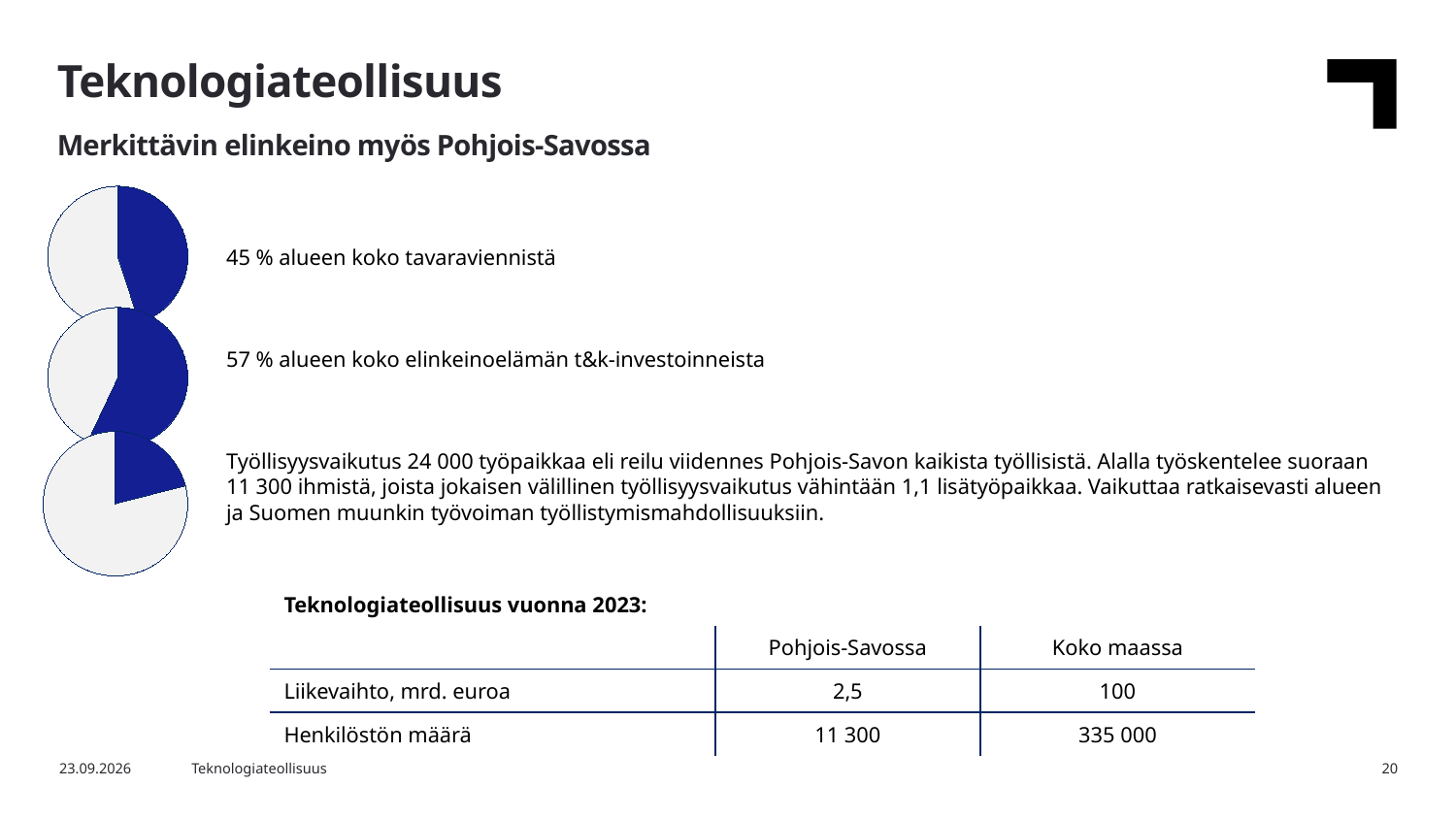
What is the difference in percentage points between the shares shown for the middle pie chart (57 %) and the top pie chart (45 %)? 12 percentage points How many pie charts are on the slide? 3 In the bottom pie chart, is the blue slice greater or less than 50% of the pie? less What kind of charts are shown on the left side of the slide? Pie charts Which pie chart has the smallest blue slice: the top, middle or bottom one? Bottom How many slices does each pie chart have? 2 In the middle pie chart, is the blue slice greater or less than 50% of the pie? greater What colour is the highlighted slice in each pie chart? Blue In the middle pie chart, what share of the region's business R&D investments does the blue slice represent, according to the text beside it? 57 % Which pie chart has the largest blue slice: the top, middle or bottom one? Middle In the top pie chart, what share of the region's total goods exports does the blue slice represent, according to the text beside it? 45 % Is the blue slice larger in the top pie chart or in the middle pie chart? Middle